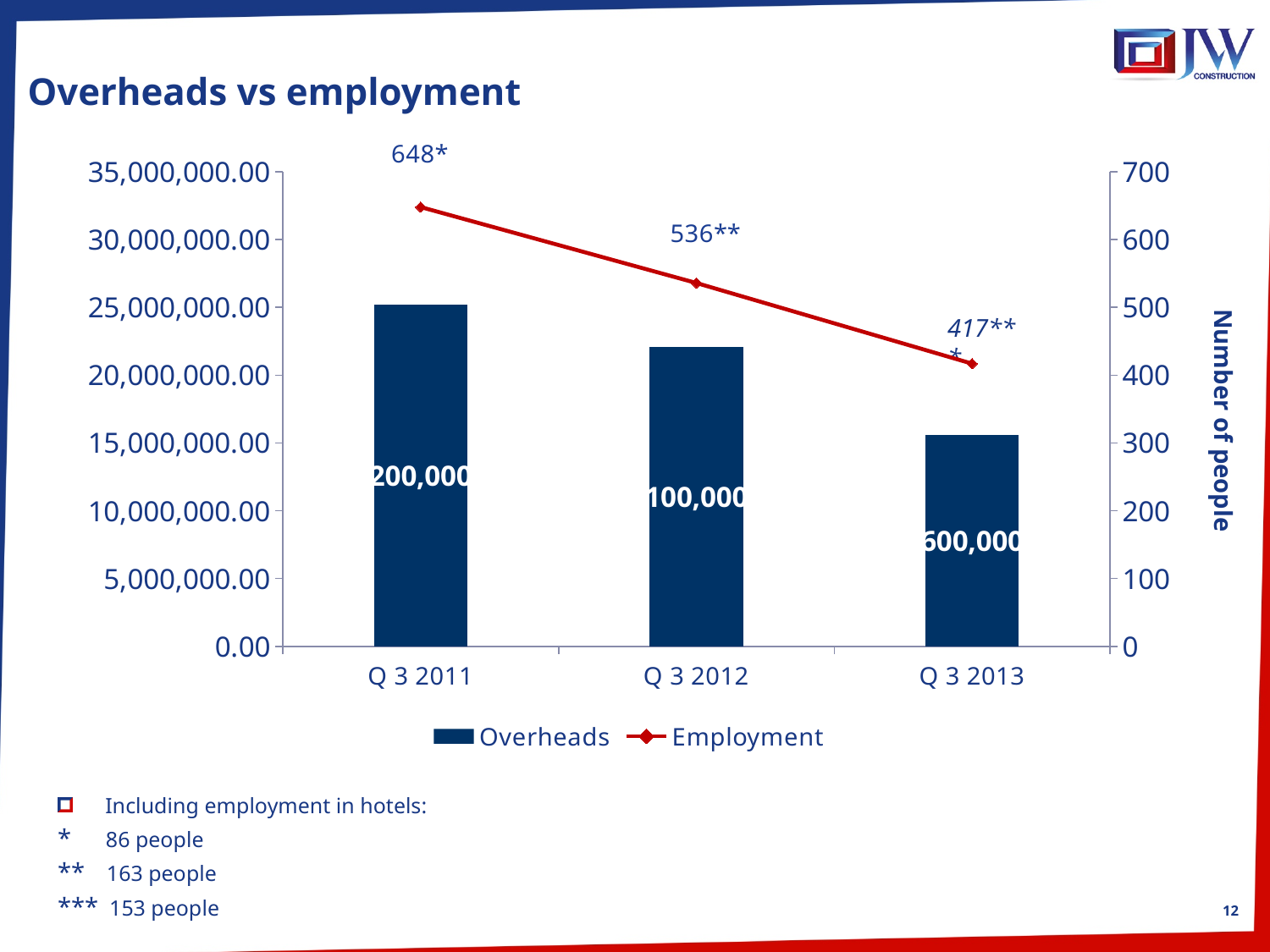
Is the Overheads value for Q 3 2011 greater or less than 20,000,000.00? greater What is the difference between the Employment values for Q 3 2011 and Q 3 2013? 231 Which quarter has the lowest Employment value? Q 3 2013 What is the Employment value for Q 3 2012? 536 Does the Employment line rise or fall from Q 3 2011 to Q 3 2013? Fall What is the title of the right-hand vertical axis? Number of people Is the Overheads value for Q 3 2013 greater or less than 20,000,000.00? less Which quarter has the highest Employment value? Q 3 2011 What is the Employment value for Q 3 2011? 648 What is the Employment value for Q 3 2013? 417 How many series does the legend list? 2 How many quarters are shown on the x axis? 3